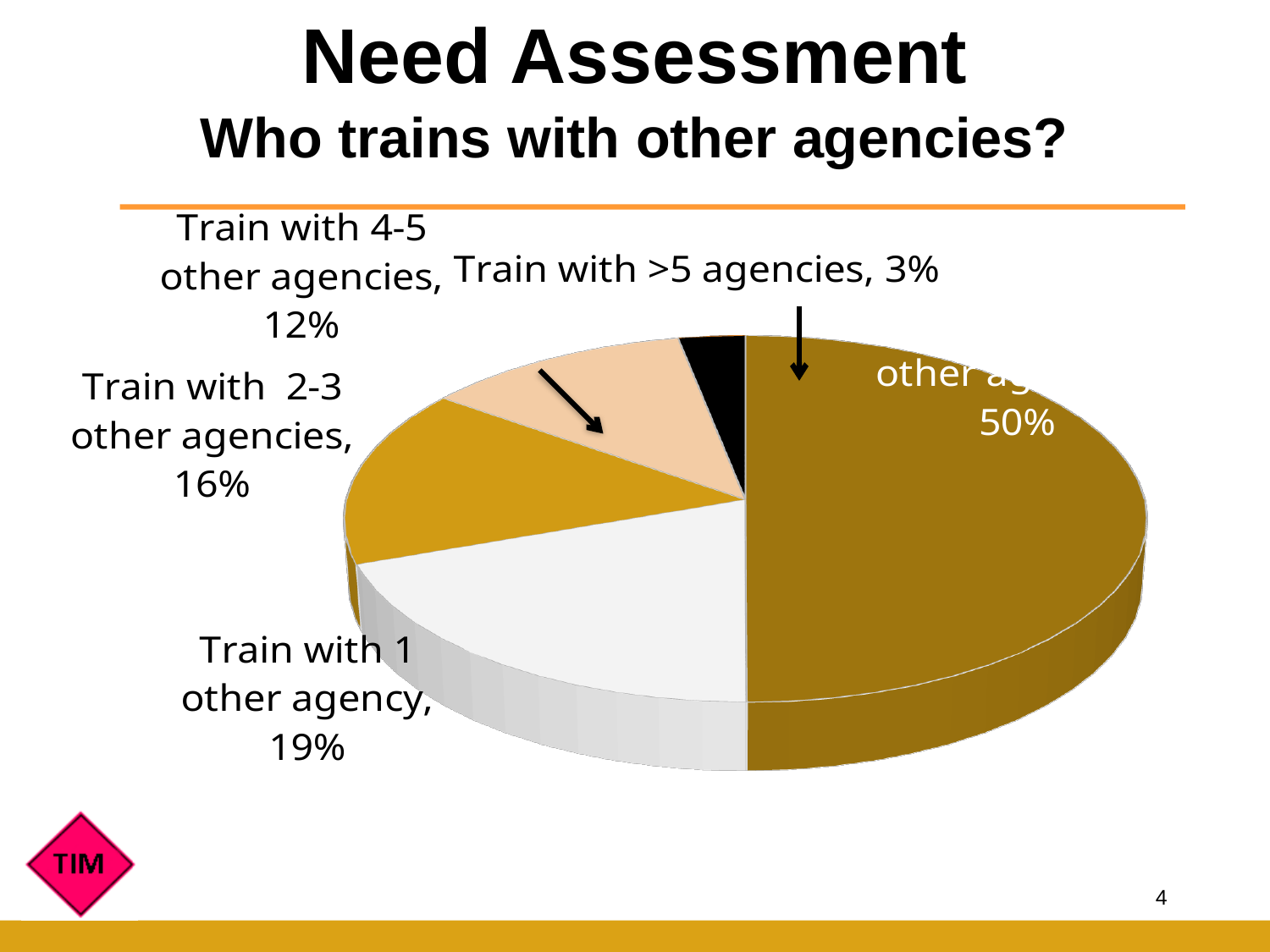
Which is larger: the share for 'Train with 1 other agency' or 'Train with 4-5 other agencies'? Train with 1 other agency What percentage of respondents train with 2-3 other agencies? 16% How many slices does the pie chart have? 5 What is the subtitle of the chart slide? Who trains with other agencies? Which category has the smallest slice of the pie? Train with >5 agencies What kind of chart is shown on the slide? pie chart What is the percentage shown for the largest slice of the pie? 50% What percentage of respondents train with >5 agencies? 3% What is the combined percentage of respondents who train with 4-5 other agencies or with >5 agencies? 15% What percentage of respondents train with 1 other agency? 19% What is the difference in percentage points between 'Train with 1 other agency' and 'Train with 2-3 other agencies'? 3 What percentage of respondents train with 4-5 other agencies? 12%